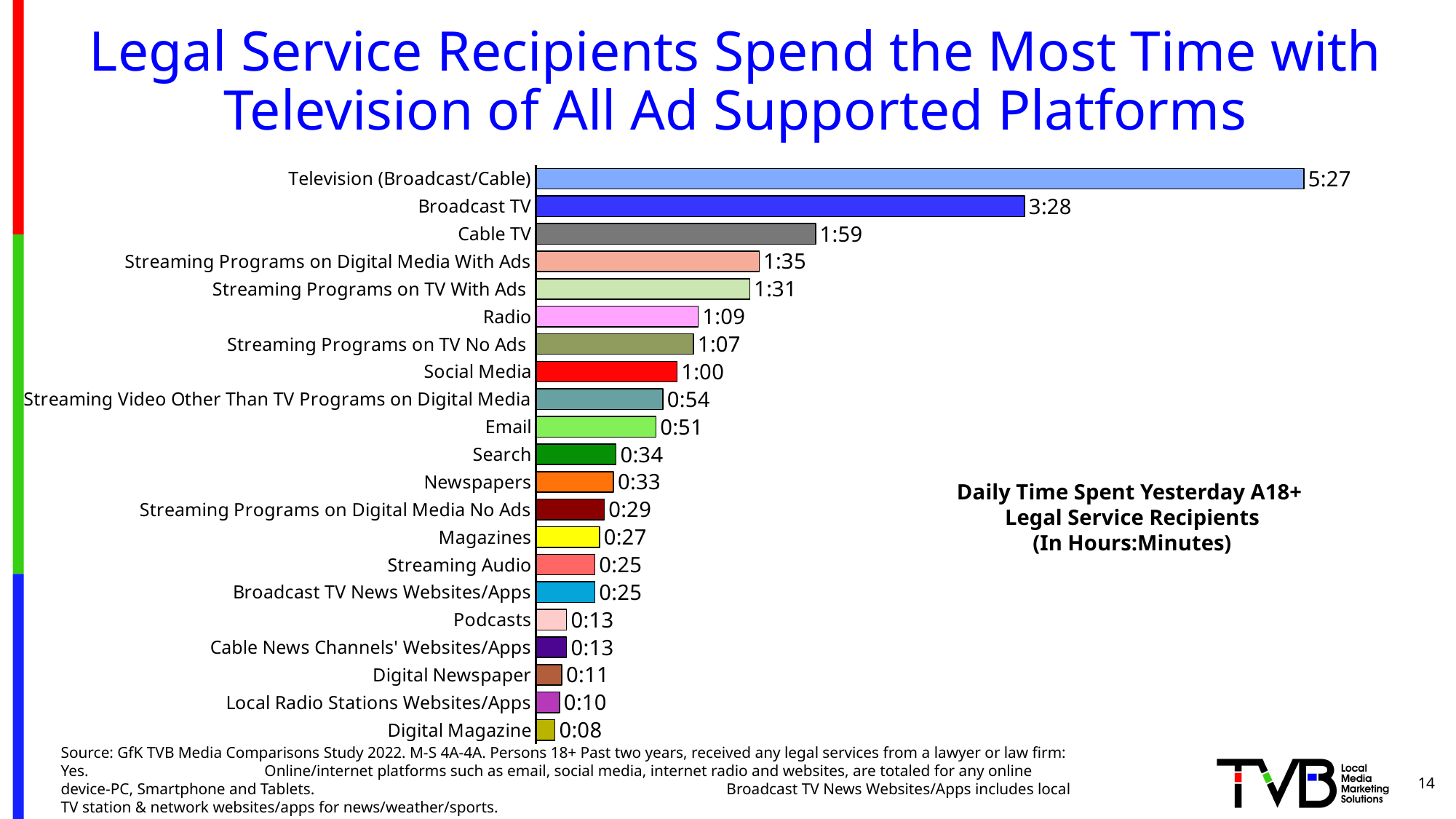
What is the daily time spent with Television (Broadcast/Cable)? 5:27 What is the value shown for Radio? 1:09 What is the difference between Search and Newspapers? 0:01 What kind of chart is shown on the slide? Bar chart Which category has the lowest value? Digital Magazine How many categories are shown in the chart? 21 Which category has the highest value? Television (Broadcast/Cable) What is the value shown for Podcasts? 0:13 Which is larger, Cable TV or Streaming Programs on Digital Media With Ads? Cable TV What is the difference between Television (Broadcast/Cable) and Broadcast TV? 1:59 In what units are the values in the chart expressed, according to the chart label? Hours:Minutes What is the value shown for Social Media? 1:00